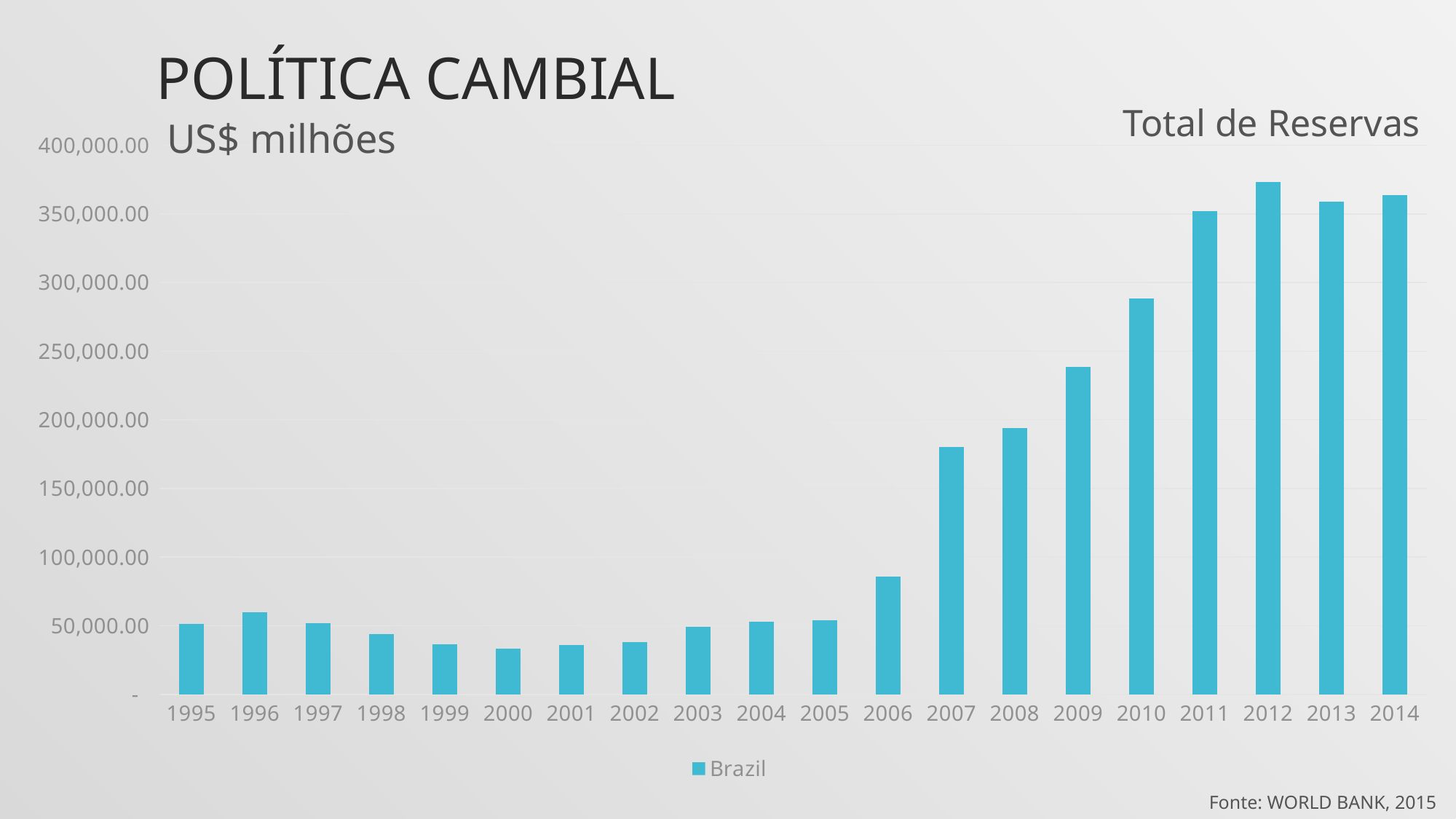
How many years are shown on the x axis? 20 Is the value for 2007 greater or less than 150,000.00? greater Is the value for 2006 greater or less than 100,000.00? less Which year has the larger value, 2009 or 2010? 2010 What kind of chart is shown on the slide? bar chart Which year has the lowest total reserves? 2000 How many series does the legend list? 1 What is the name of the series shown in the legend? Brazil Do the values generally rise or fall from 2005 to 2012? rise Which year has the highest total reserves? 2012 Is the value for 2011 greater or less than 300,000.00? greater